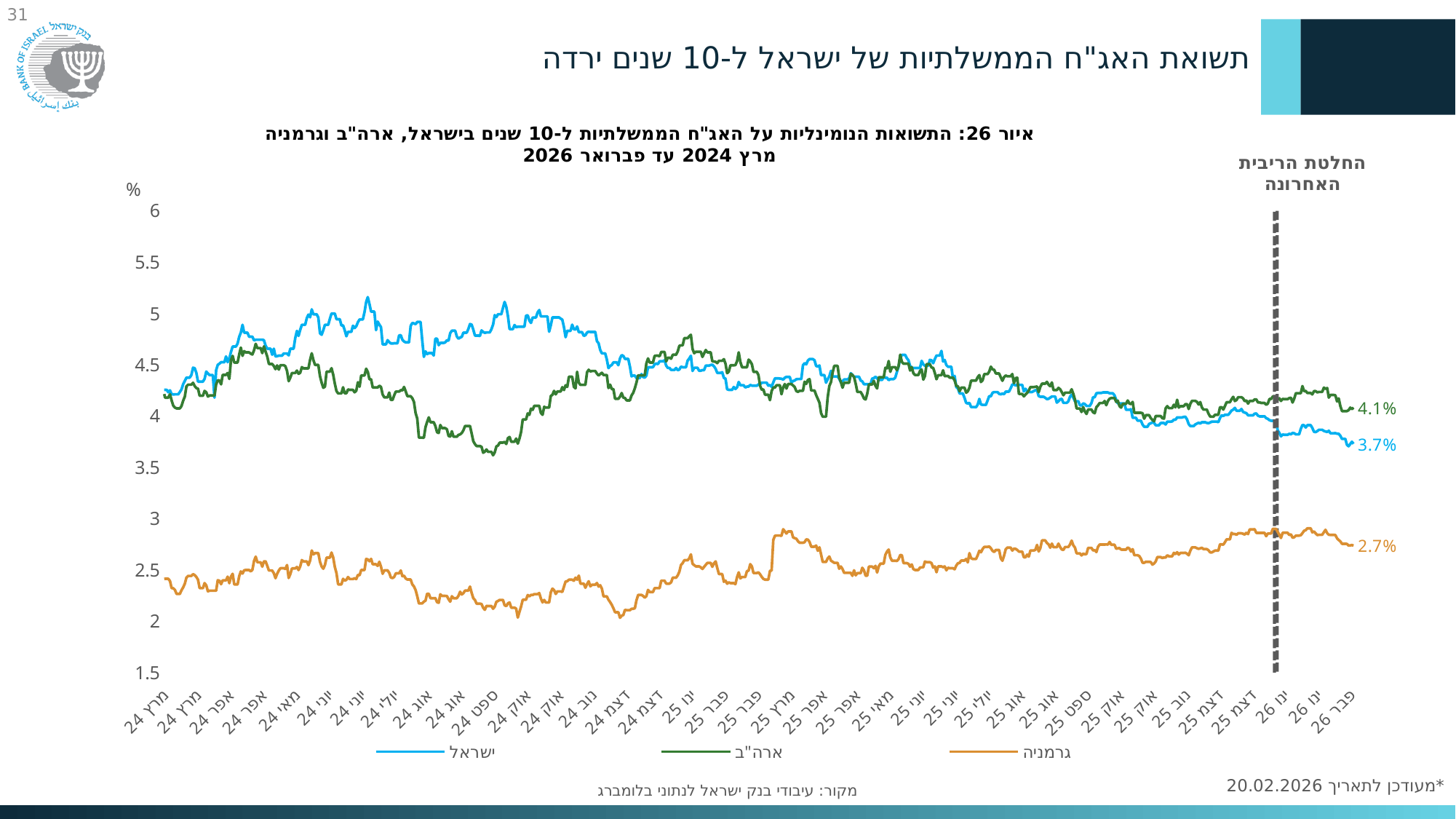
What is the latest value labelled for the גרמניה (Germany) series at the right end of the chart? 2.7% Which series has the lowest labelled value at the right end of the chart? גרמניה What is the latest value labelled for the ישראל (Israel) series at the right end of the chart? 3.7% Which colour is used for the ישראל series in the legend? light blue At the right end of the chart, is the labelled value for ישראל larger or smaller than that for ארה"ב? smaller What type of chart is shown on the slide? line chart Is the value of the גרמניה series at the end of the period greater or less than 3? less What is the difference between the end-of-period labelled values for ארה"ב and גרמניה? 1.4 percentage points What is the latest value labelled for the ארה"ב (US) series at the right end of the chart? 4.1% What is the difference between the end-of-period labelled values for ארה"ב and ישראל? 0.4 percentage points How many series does the legend list? 3 Which series has the highest labelled value at the right end of the chart? ארה"ב